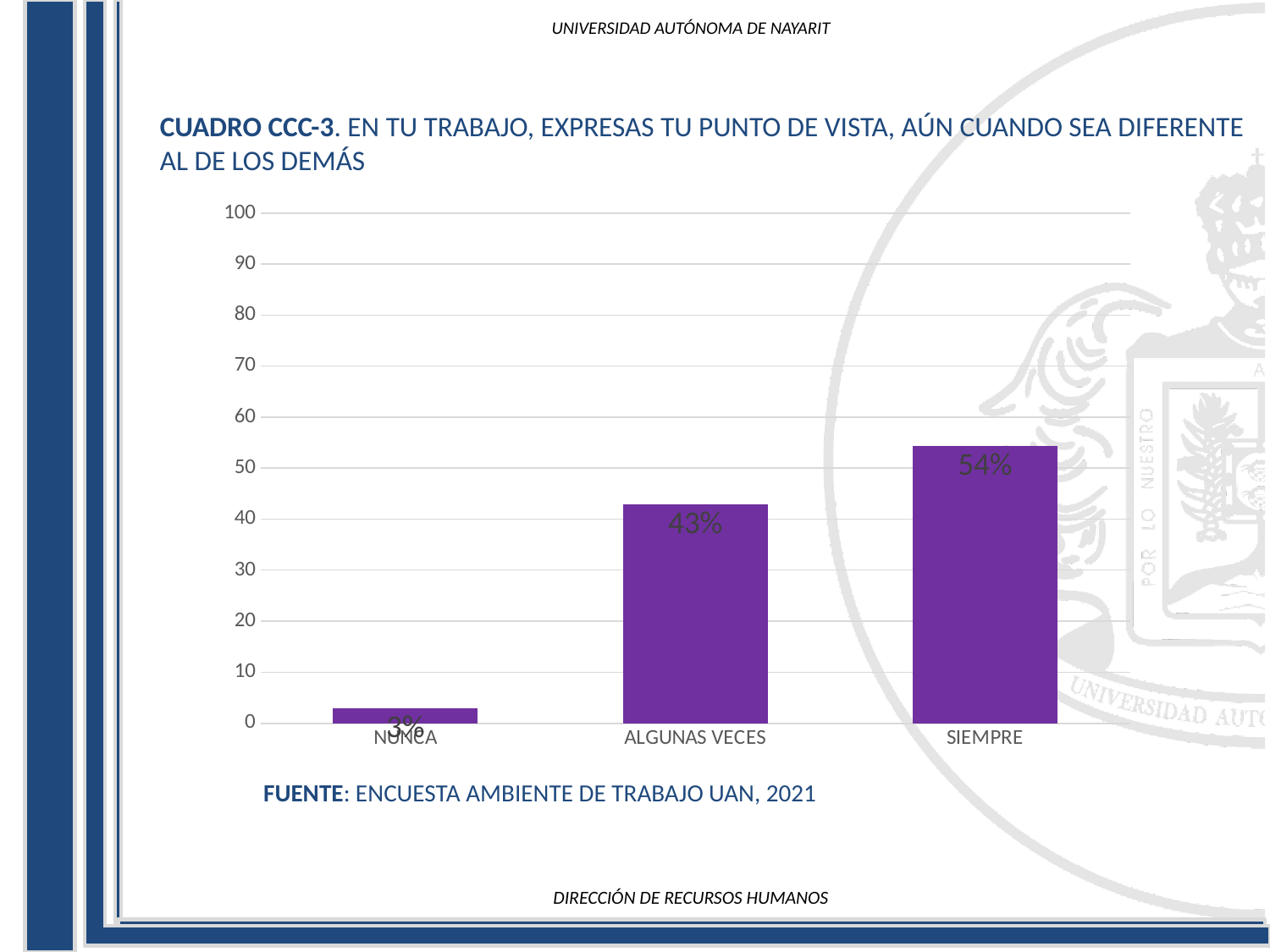
Which category has the highest value? SIEMPRE Which category has the lowest value? NUNCA What is the value for SIEMPRE? 54% How many categories are shown on the x axis? 3 Do the values rise or fall from NUNCA to SIEMPRE along the x axis? rise What kind of chart is shown on the slide? bar chart Is the value for SIEMPRE greater or less than 50? greater What is the difference between the values for ALGUNAS VECES and NUNCA? 40% Which is larger, the value for ALGUNAS VECES or the value for SIEMPRE? SIEMPRE What is the value for ALGUNAS VECES? 43% What is the value for NUNCA? 3% What is the difference between the values for SIEMPRE and ALGUNAS VECES? 11%